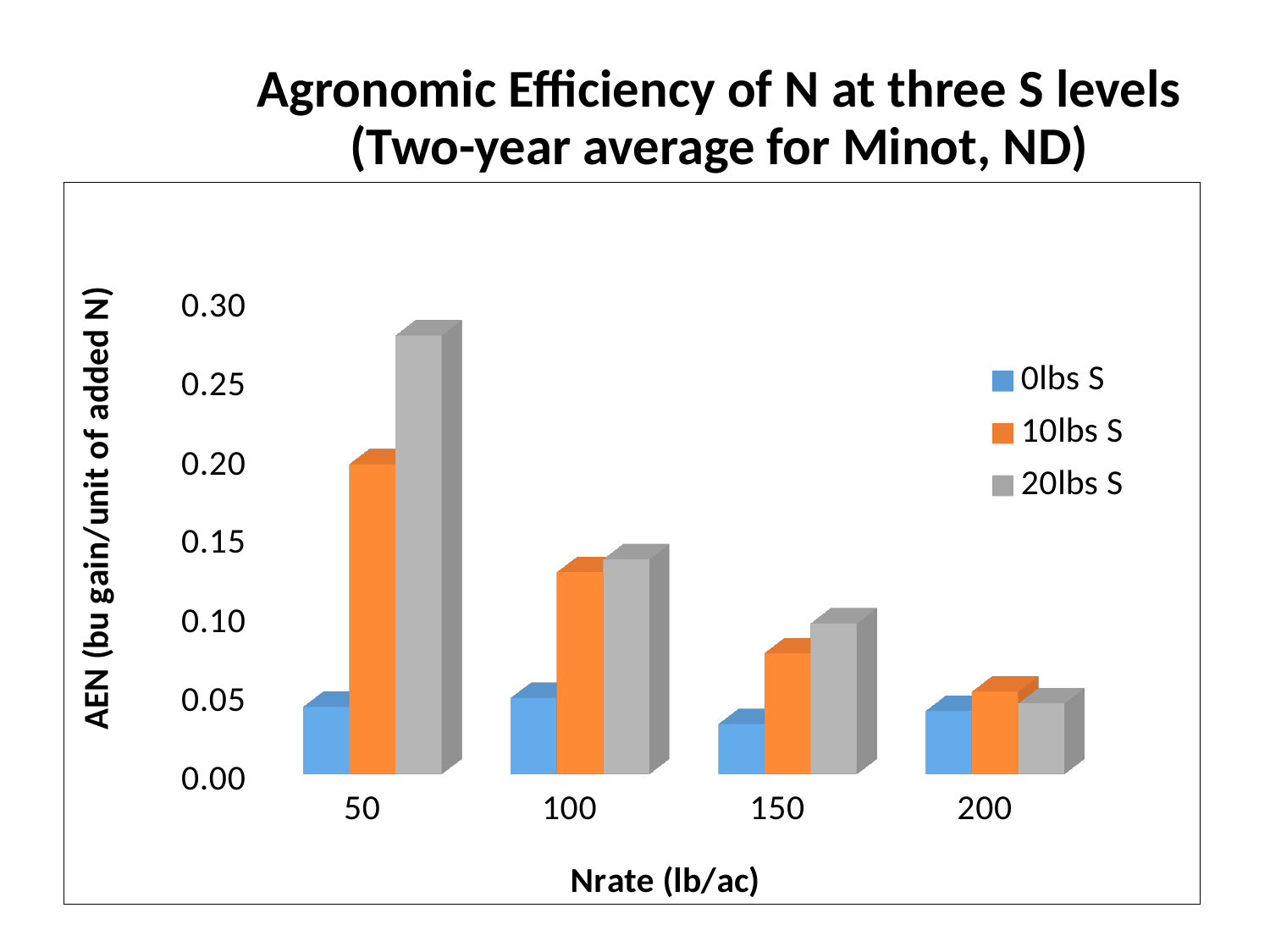
Is the value for 10lbs S at the 150 lb/ac N rate greater or less than 0.10? less Is the value for 10lbs S at the 50 lb/ac N rate greater or less than 0.15? greater Which series has the highest bar at the 50 lb/ac N rate? 20lbs S Is the value for 20lbs S at the 50 lb/ac N rate greater or less than 0.25? greater What kind of chart is shown on the slide? bar chart At which N rate does the 20lbs S series reach its highest value? 50 At which N rate is the 0lbs S bar the lowest? 150 What is the label of the y axis? AEN (bu gain/unit of added N) Does the 20lbs S series rise or fall as the N rate increases from 50 to 200? fall How many series does the legend list? 3 At the 150 lb/ac N rate, which is larger: the 10lbs S bar or the 20lbs S bar? 20lbs S How many N rate categories are shown on the x axis? 4